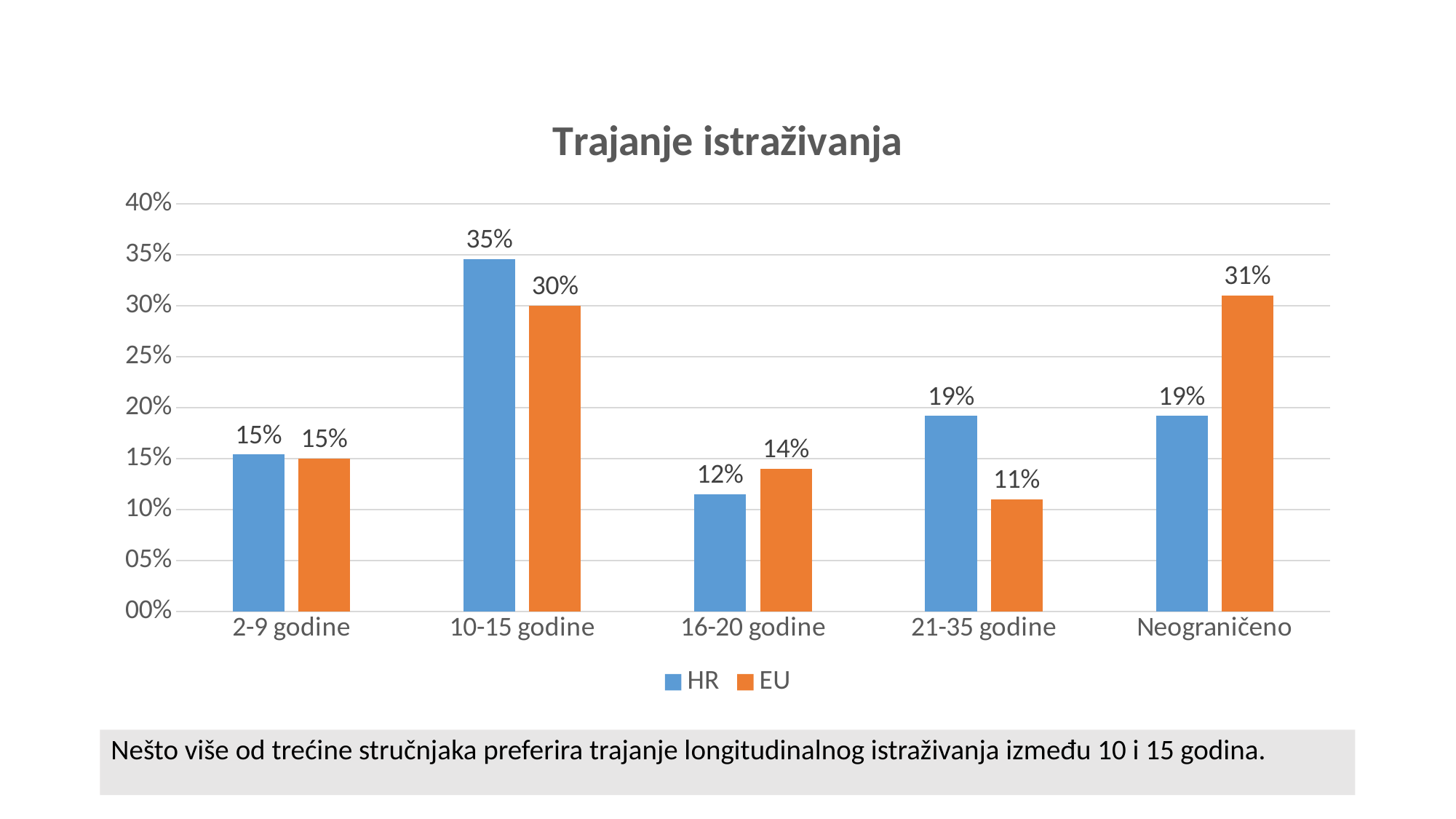
Which category has the highest HR value? 10-15 godine Is the HR value for 16-20 godine greater or less than 15%? less What is the HR value for 10-15 godine? 35% What is the EU value for Neograničeno? 31% What is the difference between the HR and EU values for 10-15 godine? 5% How many series does the legend list? 2 What kind of chart is shown? bar chart How many categories are shown on the x axis? 5 What is the title of the chart? Trajanje istraživanja Which category has the lowest EU value? 21-35 godine Which is larger for Neograničeno, the HR value or the EU value? EU What is the EU value for 21-35 godine? 11%